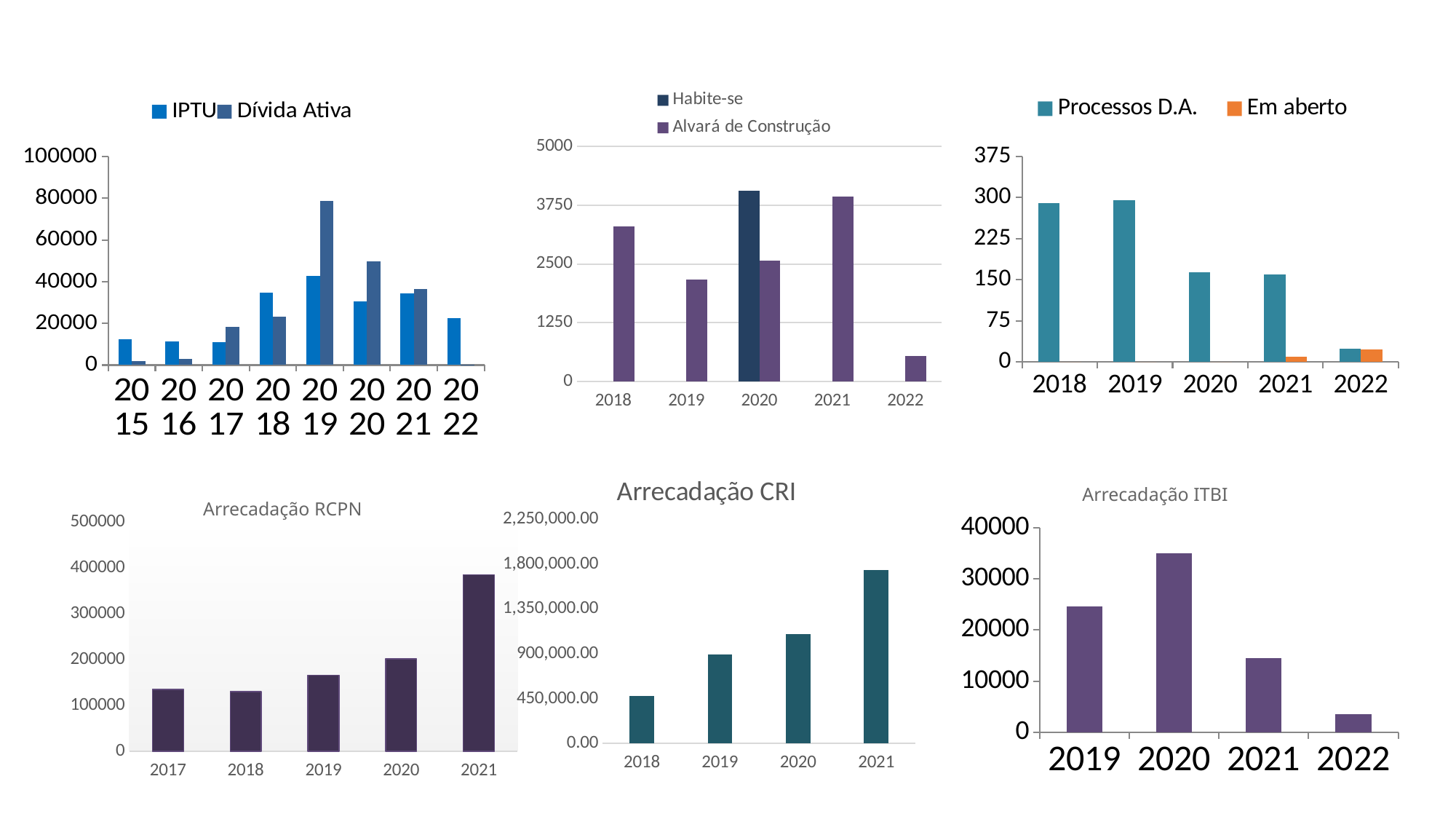
In the top-right chart with Processos D.A. and Em aberto, is the Em aberto value for 2021 greater or less than 75? less In the top-right chart with Processos D.A. and Em aberto, which year has the lowest Processos D.A. value? 2022 In the top-middle chart with Habite-se and Alvará de Construção, which year has the lowest Alvará de Construção value? 2022 In the Arrecadação ITBI chart, which year has the highest value? 2020 In the Arrecadação CRI chart, do the values rise or fall from 2018 to 2021? rise In the top-middle chart with Habite-se and Alvará de Construção, is the Habite-se value for 2020 greater or less than 3750? greater In the Arrecadação RCPN chart, is the value for 2021 greater or less than 300000? greater In the top-left chart with IPTU and Dívida Ativa, how many series does the legend list? 2 In the Arrecadação RCPN chart, how many years are shown on the x axis? 5 In the top-left chart with IPTU and Dívida Ativa, which year has the highest Dívida Ativa value? 2019 In the top-middle chart with Habite-se and Alvará de Construção, which year has the highest Alvará de Construção value? 2021